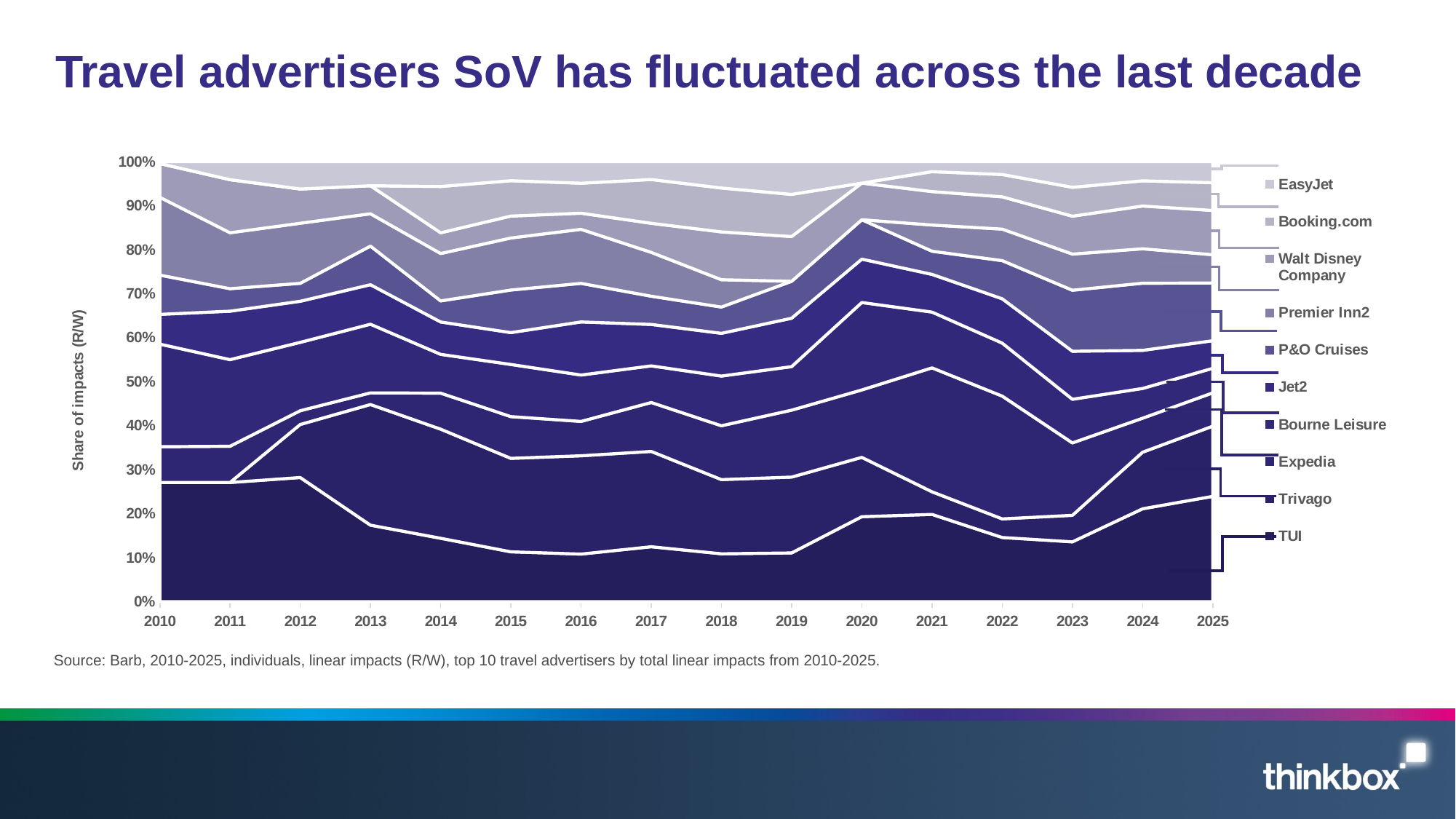
Is the value for TUI in 2025 greater or less than 20%? greater Which advertiser is the top series of the stacked area chart? EasyJet Is the value for TUI in 2015 greater or less than 20%? less Which advertiser is the bottom series of the stacked area chart? TUI How many advertisers (series) does the legend list? 10 Does the value for TUI rise or fall from 2023 to 2025? rise Does the value for TUI rise or fall from 2012 to 2015? fall Which is larger, the value for TUI in 2010 or in 2015? 2010 Is the value for TUI in 2010 greater or less than 20%? greater How many years are shown along the x axis? 16 What kind of chart is shown on the slide? Stacked area chart